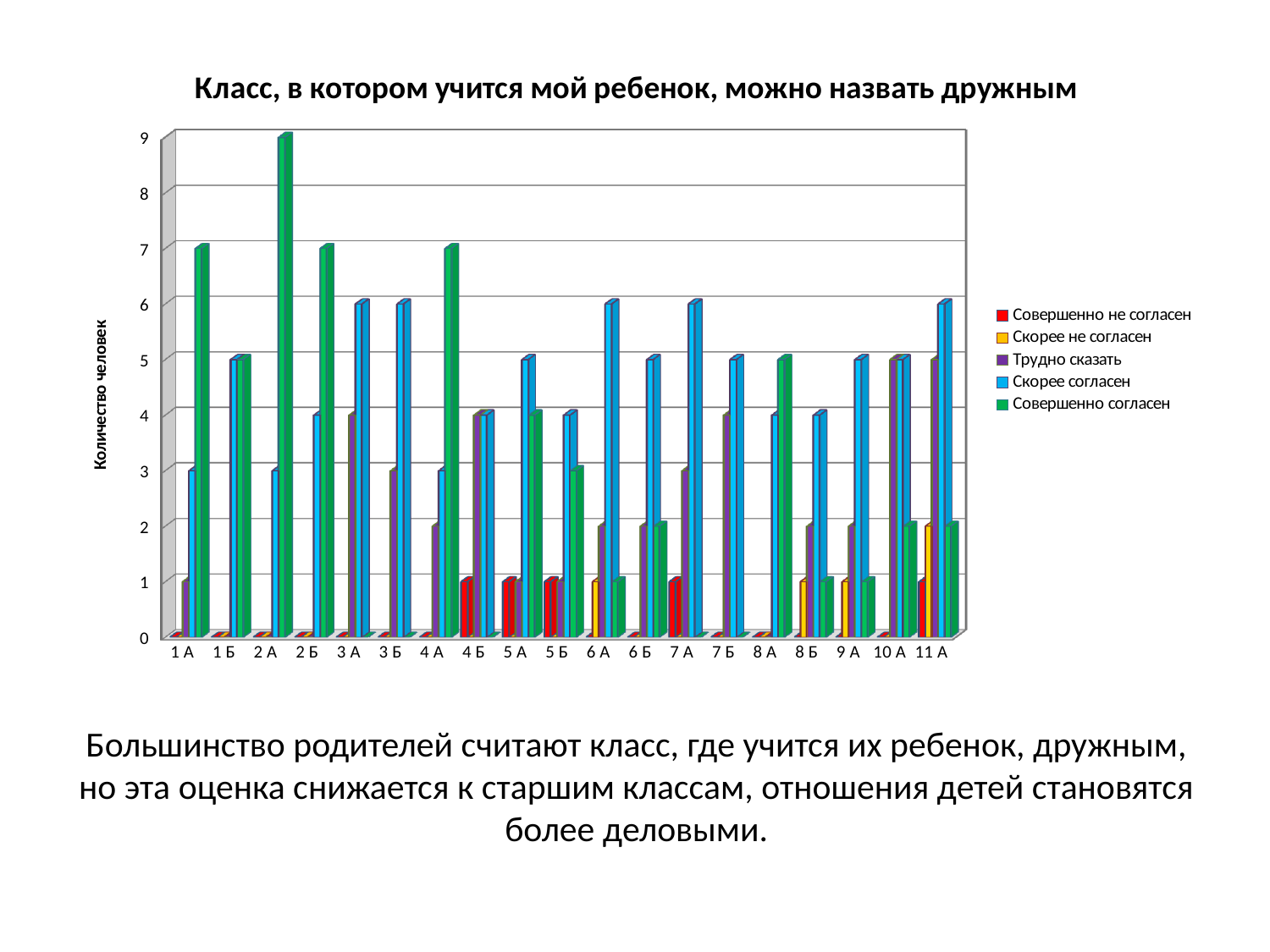
Is the value for "Совершенно согласен" in class 2 А greater or less than 8? greater What is the value for "Совершенно согласен" in class 1 А? 7 How many series does the legend list? 5 What is the value for "Совершенно согласен" in class 2 А? 9 How many classes are shown on the x axis? 19 What is the value for "Скорее не согласен" in class 11 А? 2 What is the title of the chart? Класс, в котором учится мой ребенок, можно назвать дружным What is the value for "Скорее согласен" in class 3 А? 6 In class 1 А, which is larger: "Совершенно согласен" or "Скорее согласен"? Совершенно согласен What kind of chart is shown on the slide? bar chart Which class has the highest value for "Совершенно согласен"? 2 А What is the difference between "Совершенно согласен" and "Скорее согласен" in class 2 А? 6